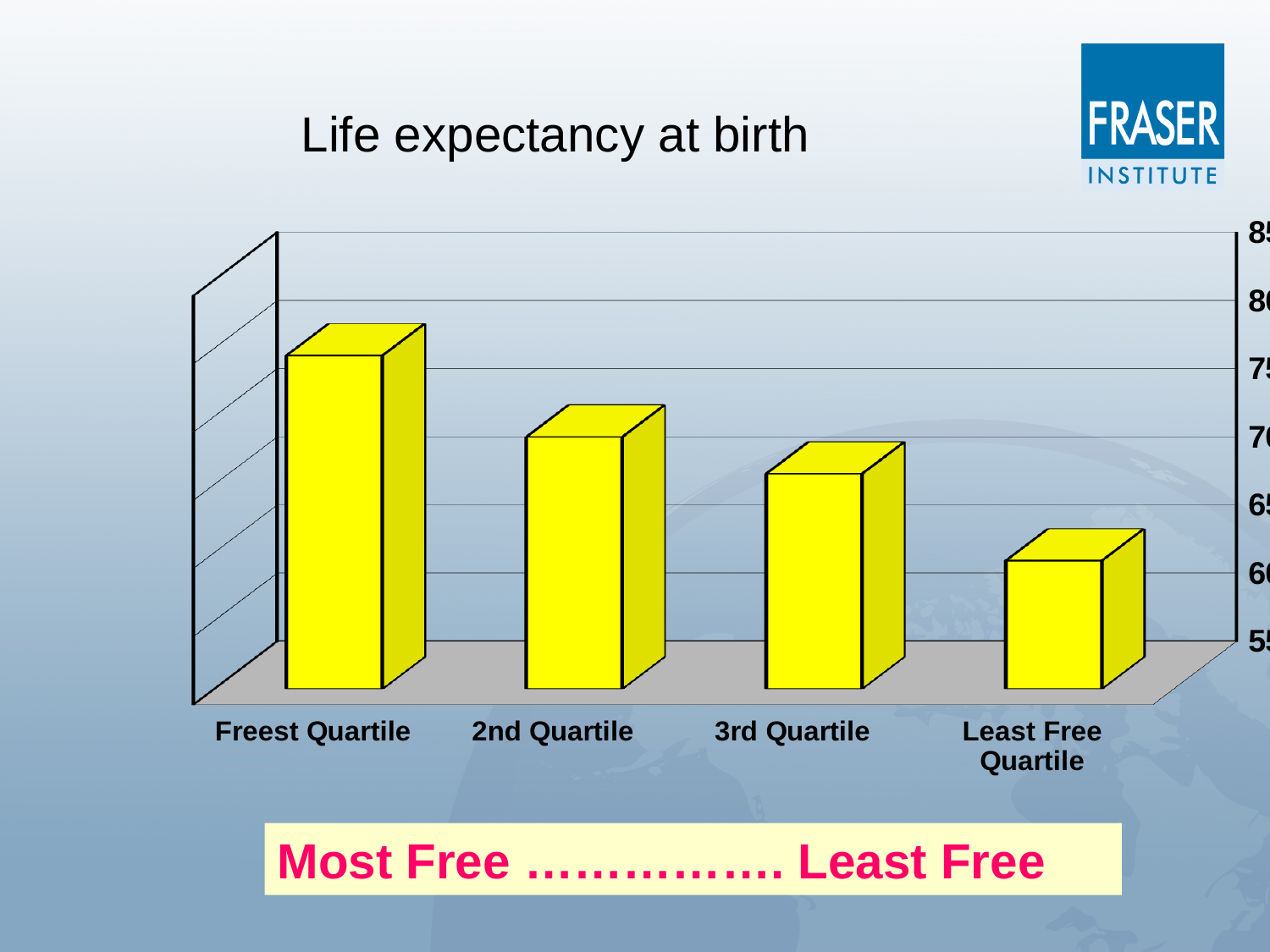
Which is larger, the value for 2nd Quartile or the value for 3rd Quartile? 2nd Quartile Which category has the lowest life expectancy at birth? Least Free Quartile What is the title of the chart? Life expectancy at birth How many categories are plotted in the chart? 4 Is the value for Least Free Quartile greater or less than 65? less What kind of chart is shown on the slide? bar chart Which category has the highest life expectancy at birth? Freest Quartile What colour are the bars in the chart? yellow Do the values rise or fall moving from Freest Quartile to Least Free Quartile along the x axis? fall Is the value for Freest Quartile greater or less than 70? greater Which is larger, the value for Freest Quartile or the value for Least Free Quartile? Freest Quartile